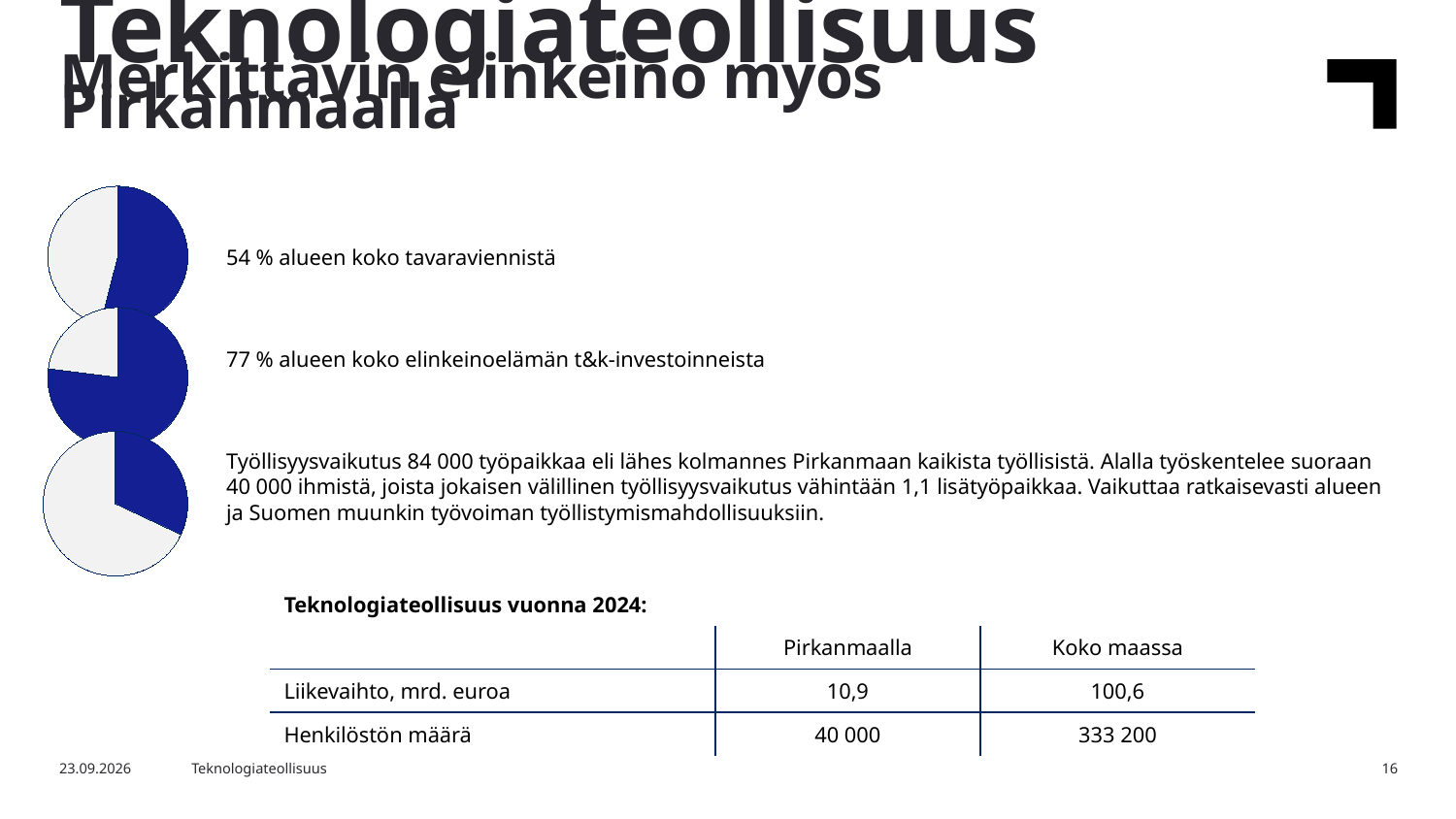
What colour is used for the highlighted slice in the pie charts? Blue What does the highlighted slice of the top pie chart represent, according to the text next to it? 54 % alueen koko tavaraviennistä Which pie chart has the larger highlighted slice, the top one or the middle one? The middle one How many pie charts are shown on the slide? 3 In the top pie chart, what share of the region's total goods exports (tavaravienti) does the highlighted slice represent? 54 % In the middle pie chart, what share of the region's business R&D investments (t&k-investoinnit) does the highlighted slice represent? 77 % Is the highlighted slice in the top pie chart greater or less than 50 %? greater Which of the three pie charts has the largest highlighted slice? The middle one (77 %) Which of the three pie charts has the smallest highlighted slice? The bottom one What is the difference in percentage points between the highlighted shares of the middle pie chart (77 %) and the top pie chart (54 %)? 23 percentage points What kind of chart is the top chart on the left side of the slide? Pie chart Is the highlighted slice in the bottom pie chart greater or less than 50 %? less